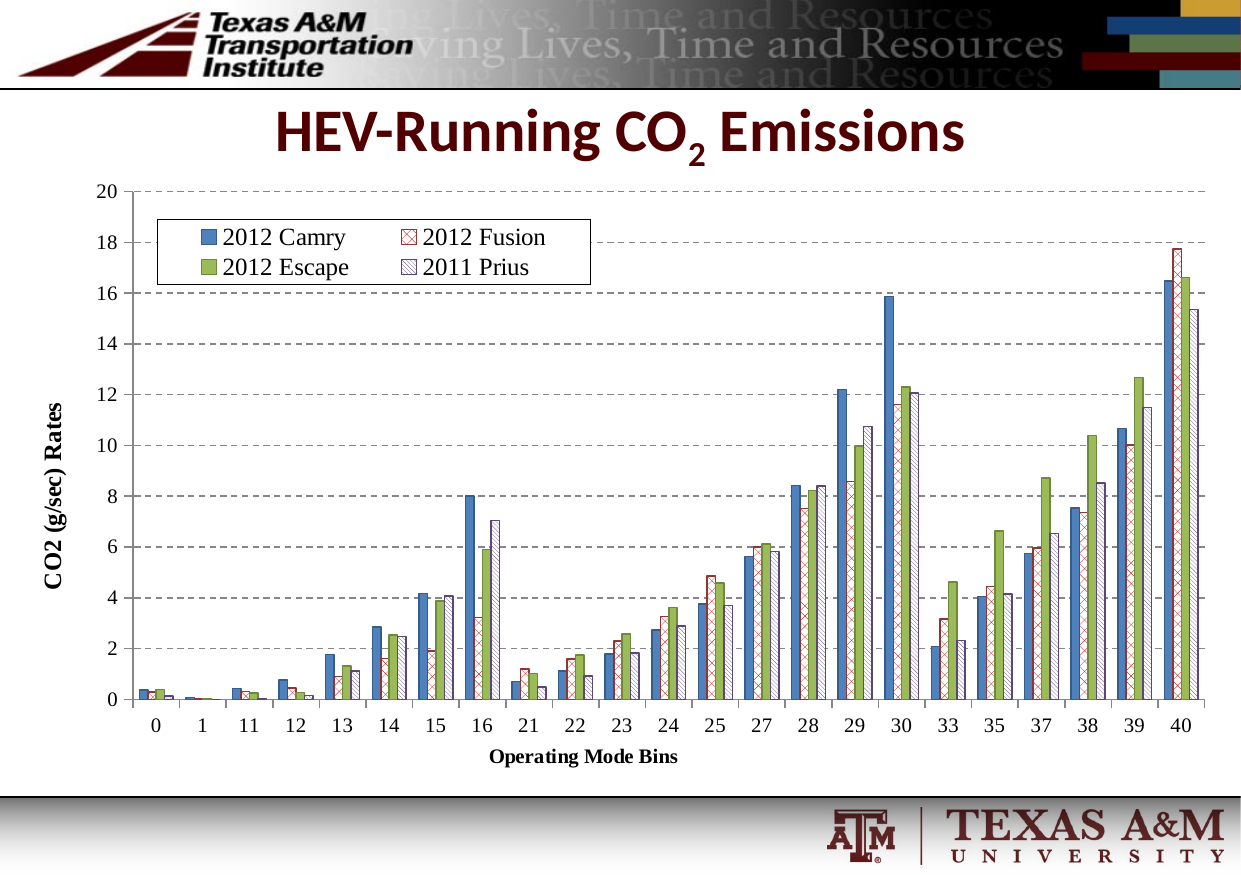
At bin 16, which is larger: 2012 Camry or 2012 Fusion? 2012 Camry What is the title of the y axis? CO2 (g/sec) Rates At bin 35, which is larger: 2012 Escape or 2012 Camry? 2012 Escape What kind of chart is shown on the slide? bar chart How many series does the legend list? 4 How many operating mode bins are shown on the x axis? 23 Is the value for 2012 Escape at bin 39 greater or less than 10? greater Is the value for 2012 Camry at bin 30 greater or less than 14? greater Is the value for 2012 Fusion at bin 33 greater or less than 4? less From bin 27 to bin 30, do the values for 2012 Camry rise or fall? rise Which series has the lowest value at bin 16? 2012 Fusion Which operating mode bin has the highest value for 2012 Fusion? 40